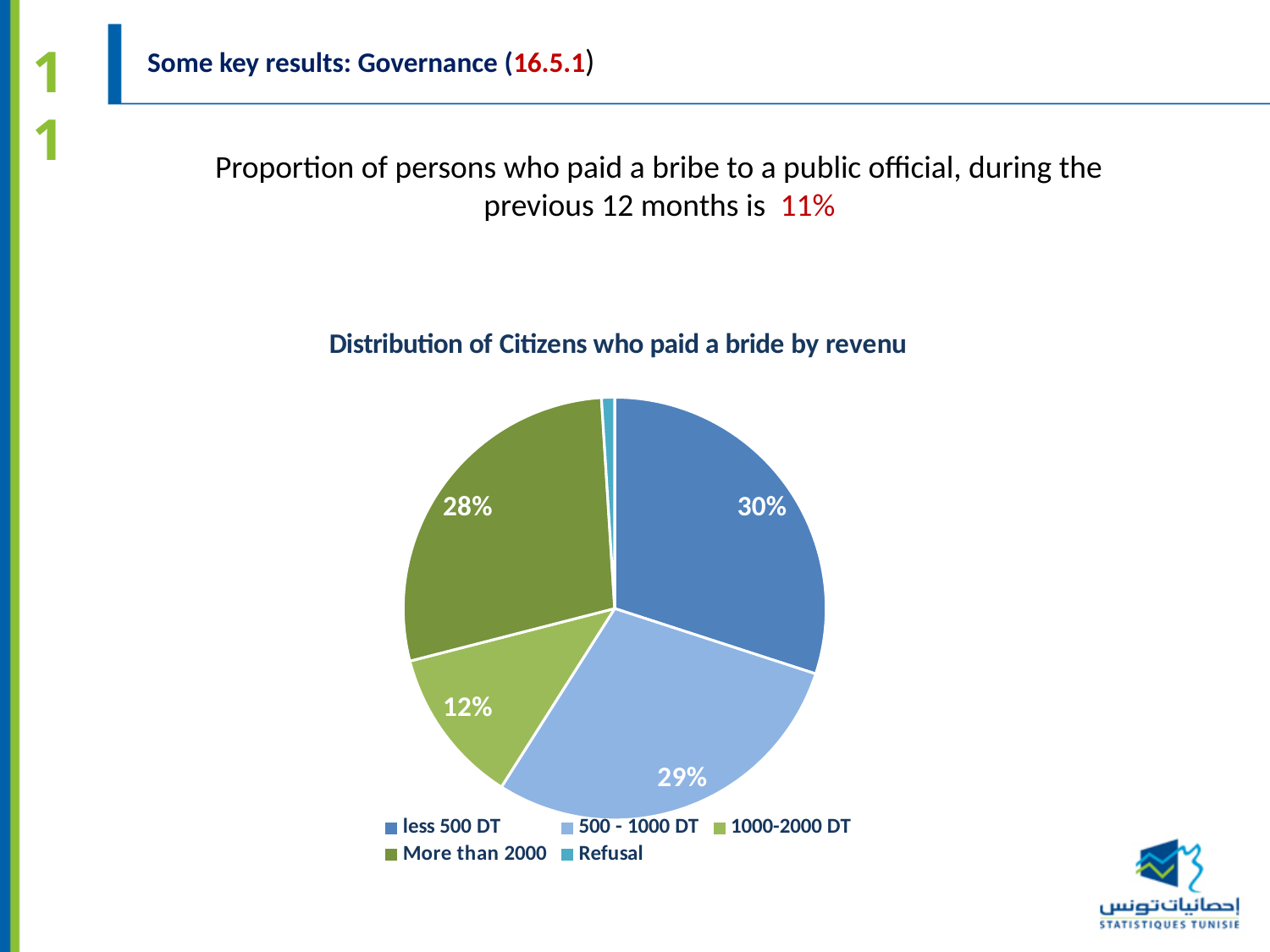
How many categories does the legend list? 5 Which is larger, the 'More than 2000' slice or the '1000-2000 DT' slice? More than 2000 Which category has the smallest slice of the pie? Refusal What is the difference between the 'less 500 DT' slice and the '1000-2000 DT' slice? 18% What type of chart is shown on the slide? pie chart What value is shown for the '500 - 1000 DT' slice? 29% Which category has the largest slice of the pie? less 500 DT What is the title of the chart? Distribution of Citizens who paid a bride by revenu What percentage of the pie corresponds to the 'less 500 DT' category? 30% What value is shown for the '1000-2000 DT' slice? 12% What is the difference between the '500 - 1000 DT' slice and the 'More than 2000' slice? 1% What share of the pie does the 'More than 2000' category take? 28%